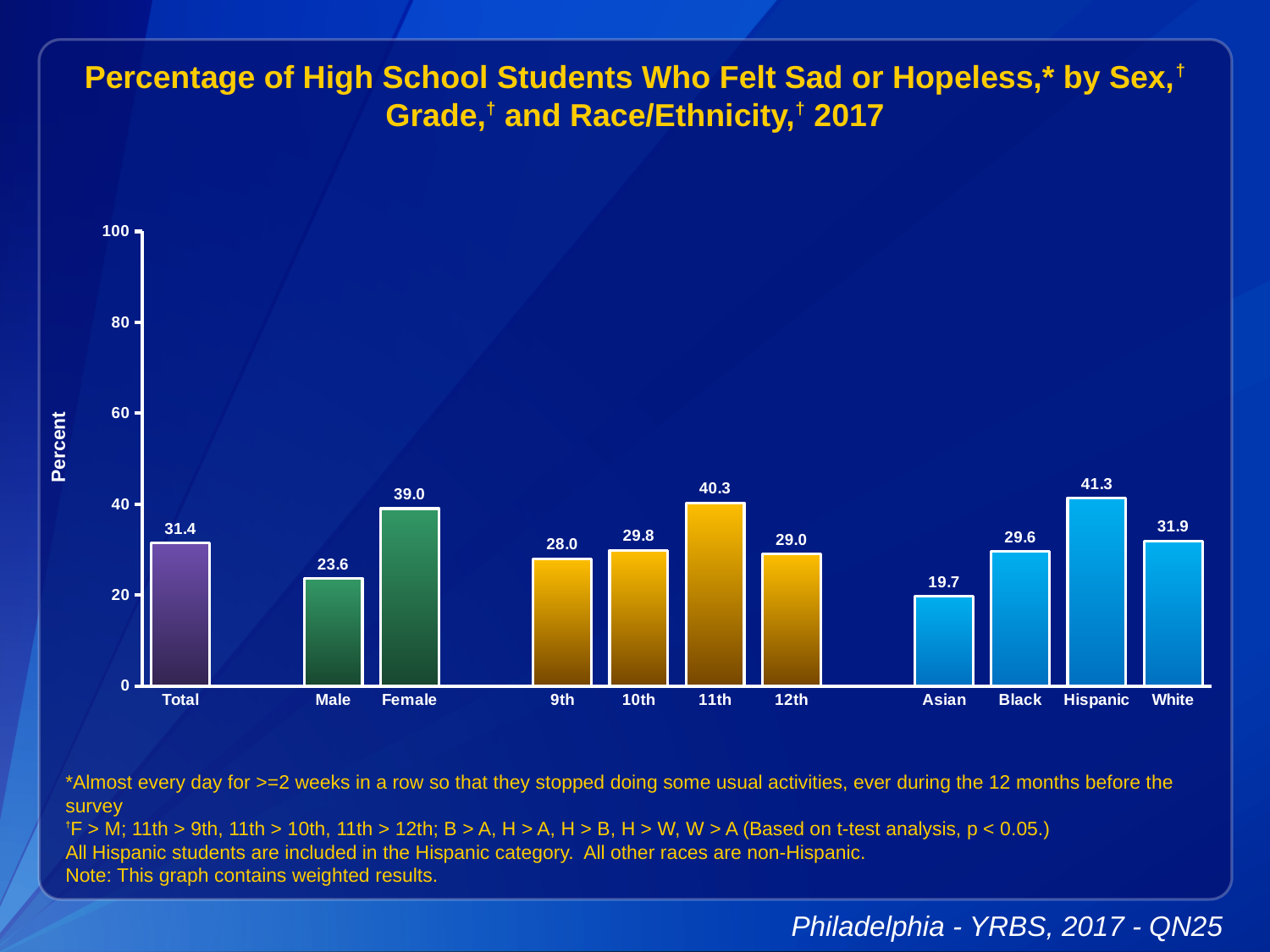
Which category has the highest value? Hispanic What is the difference between the Female and Male values? 15.4 Which is larger, the value for 11th grade or the value for 12th grade? 11th What is the value for Asian students? 19.7 What is the difference between the Hispanic and White values? 9.4 What is the label on the vertical axis? Percent What is the value for the Total bar? 31.4 What kind of chart is shown on the slide? Bar chart Is the value for Male greater or less than 20? greater What is the value for Female? 39.0 How many bars are shown in the chart? 11 Which category has the lowest value? Asian